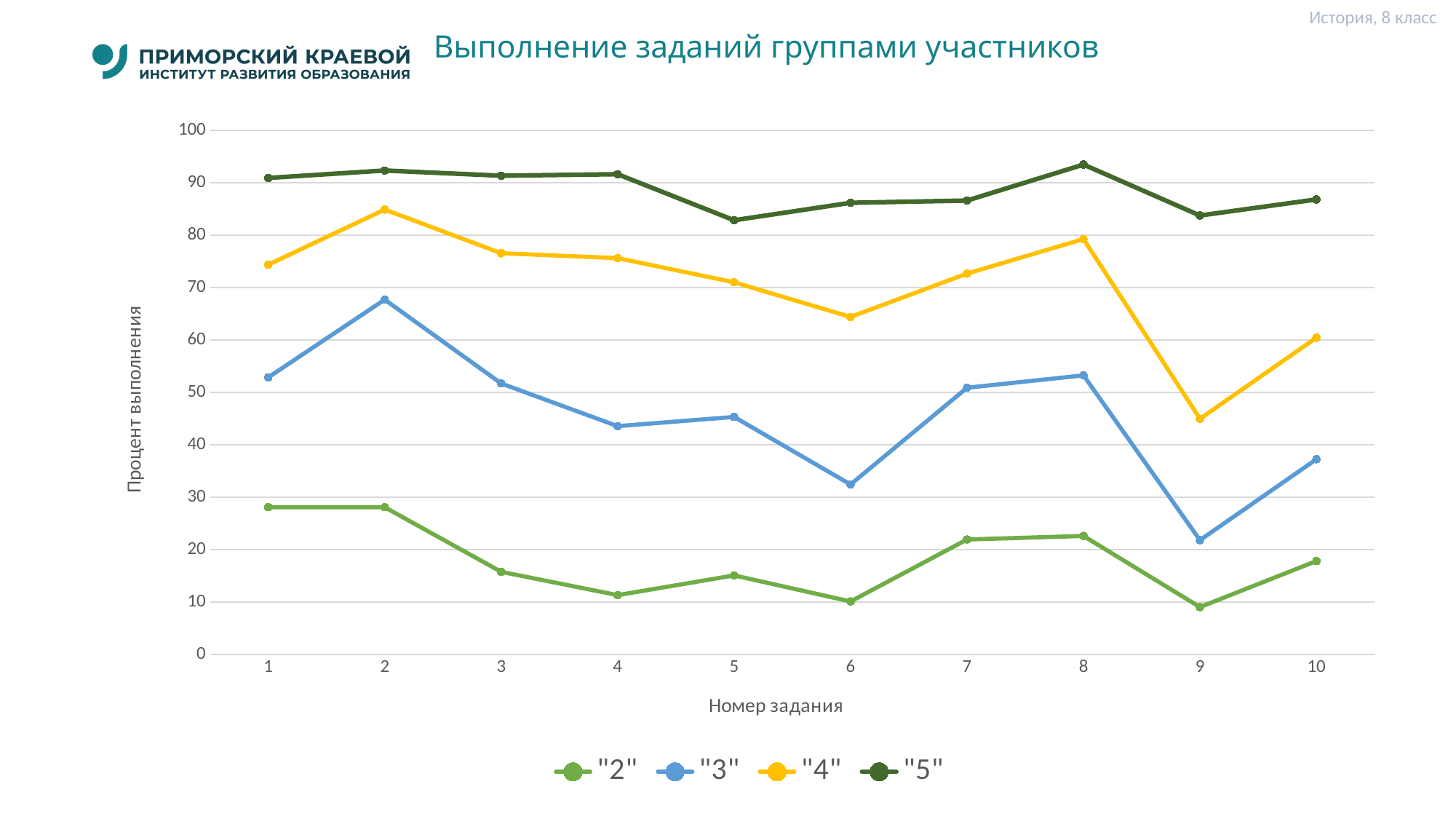
Does the series "4" rise or fall from task 8 to task 9? fall For which task number does the series "5" reach its highest value? 8 Is the value for series "5" at task 8 greater or less than 90? greater At task 9, which series has the larger value, "4" or "3"? "4" For which task number does the series "3" reach its lowest value? 9 What is the title of the vertical axis? Процент выполнения What kind of chart is shown on the slide? Line chart How many series does the legend list? 4 How many task numbers are plotted along the x axis? 10 Is the value for series "4" at task 9 greater or less than 50? less Is the value for series "3" at task 6 greater or less than 40? less For which task number does the series "4" reach its highest value? 2